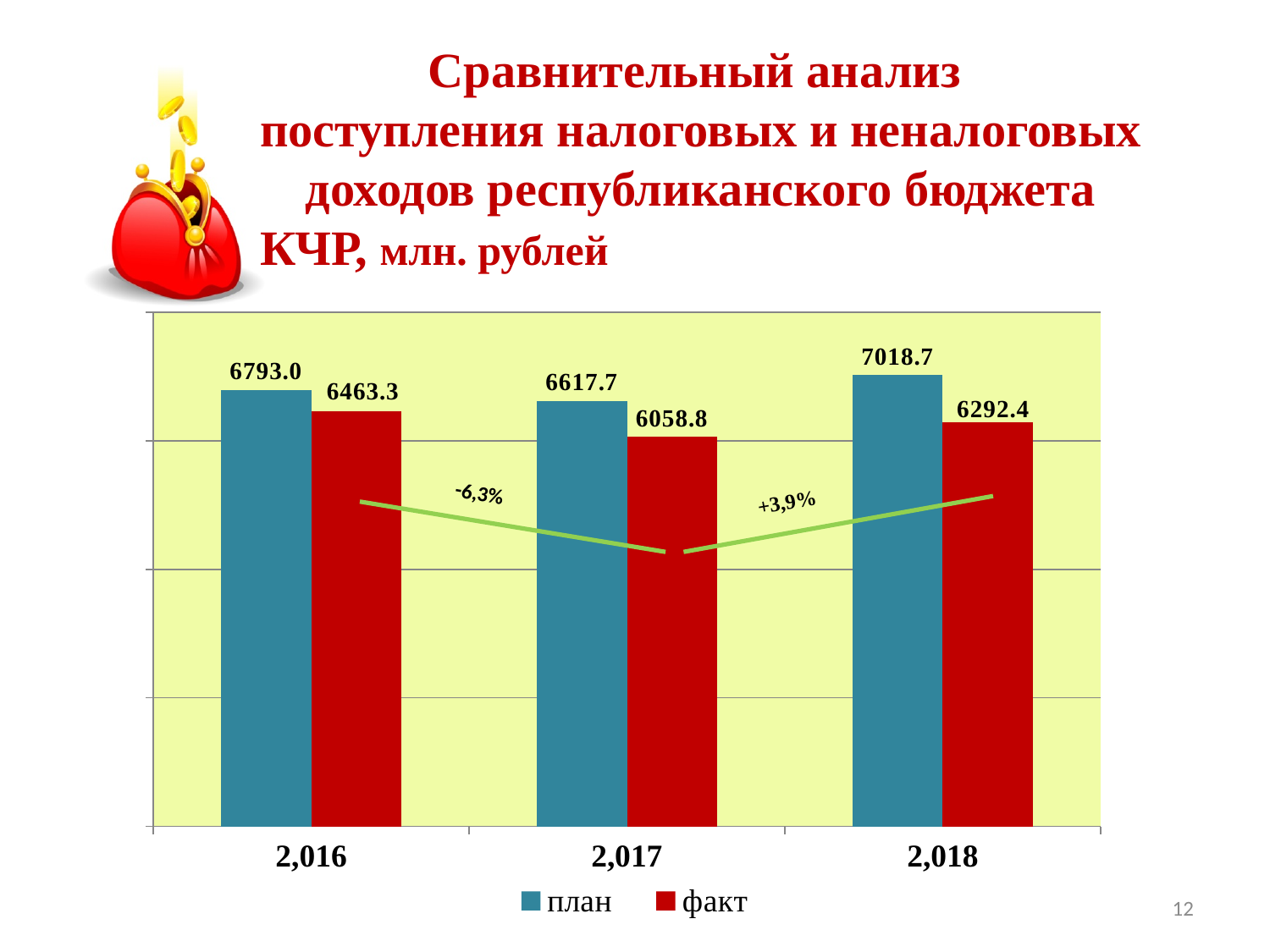
What is the difference between the planned and actual values in 2018? 726.3 How many years are shown on the x axis? 3 How many series does the legend list? 2 What percentage change is labelled on the line between 2017 and 2018? +3,9% What is the actual (факт) value for 2018? 6292.4 In which year is the planned (план) value the highest? 2018 What is the actual (факт) value for 2017? 6058.8 What is the planned (план) value for 2016? 6793.0 What kind of chart is shown on the slide? bar chart What is the difference between the planned and actual values in 2016? 329.7 In which year is the actual (факт) value the lowest? 2017 Which is larger in 2017: the planned (план) value or the actual (факт) value? план